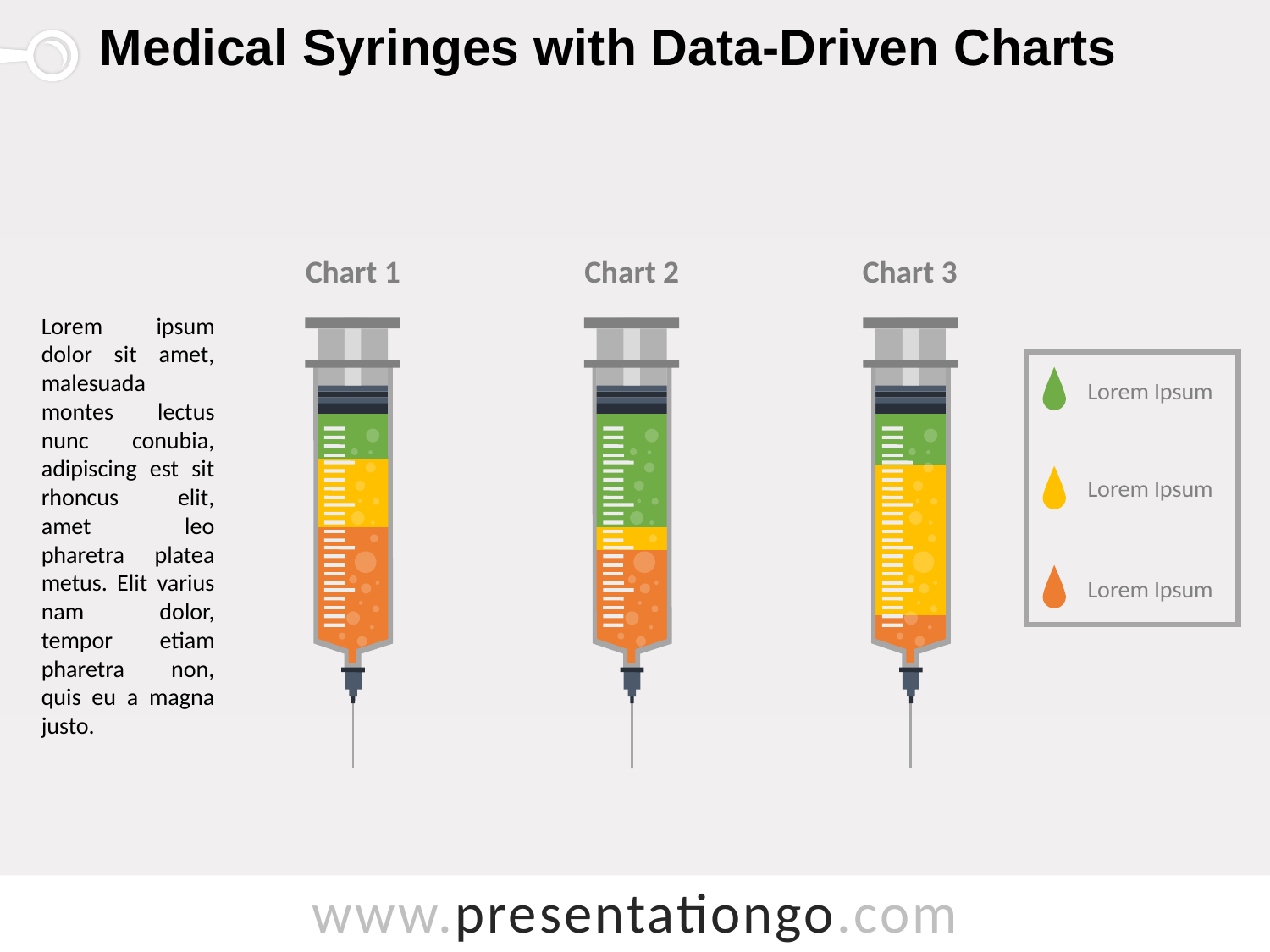
In Chart 1, which coloured segment takes up the smallest part of the syringe? Green What are the titles of the three charts, from left to right? Chart 1, Chart 2, Chart 3 In Chart 3, is the green segment larger or smaller than the yellow segment? Smaller Which three colours are used for the segments in the charts? Green, yellow, orange In Chart 1, which coloured segment takes up the largest part of the syringe? Orange In Chart 2, which coloured segment takes up the largest part of the syringe? Green How many syringe charts are shown on the slide? 3 In Chart 3, which coloured segment takes up the largest part of the syringe? Yellow In Chart 2, which coloured segment takes up the smallest part of the syringe? Yellow How many entries does the legend on the right list? 3 In Chart 3, which coloured segment takes up the smallest part of the syringe? Orange In Chart 2, is the green segment larger or smaller than the orange segment? Larger